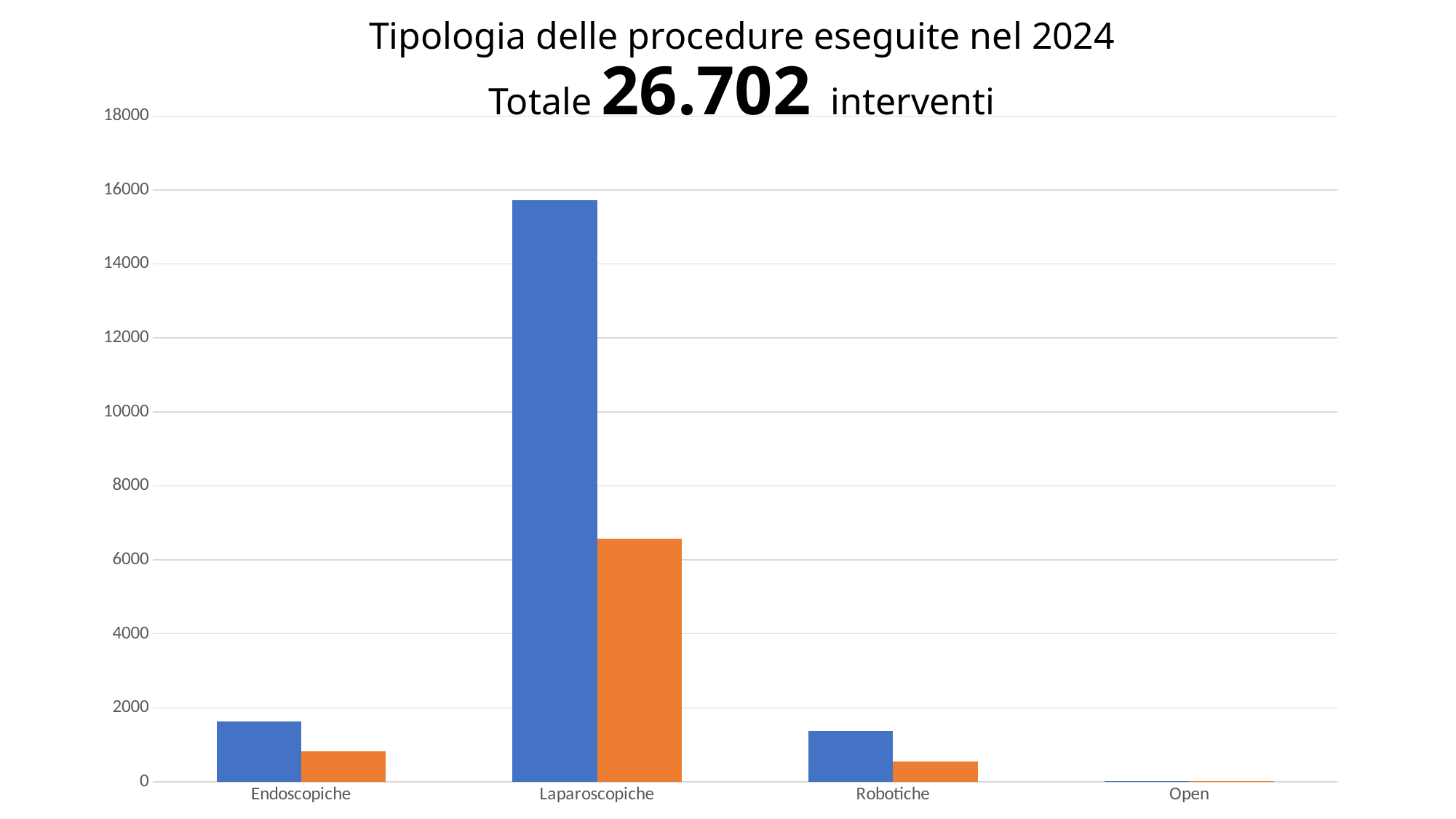
Is the value of the blue bar for Endoscopiche greater or less than 2000? less What is the title of the chart? Tipologia delle procedure eseguite nel 2024 Totale 26.702 interventi What total number of interventions is stated in the chart title? 26.702 Is the value of the orange bar for Laparoscopiche greater or less than 6000? greater Is the value of the blue bar for Robotiche greater or less than 2000? less Which category has the highest bar? Laparoscopiche What kind of chart is shown on the slide? bar chart Which is larger, the orange bar for Laparoscopiche or the orange bar for Endoscopiche? Laparoscopiche Which category has the lowest values? Open How many categories are shown on the x axis? 4 Which is larger, the blue bar for Endoscopiche or the blue bar for Robotiche? Endoscopiche